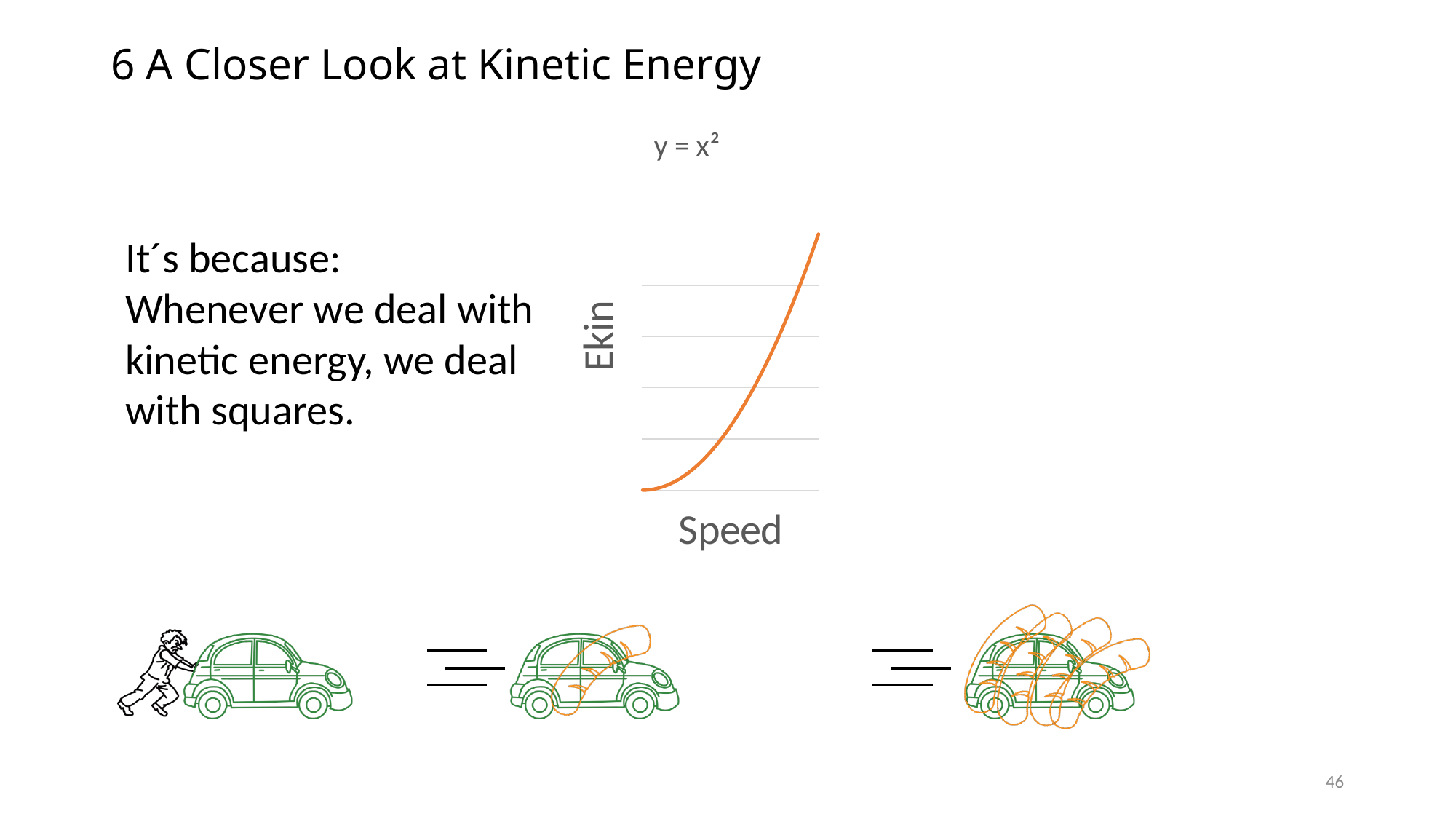
What is the label on the vertical axis of the chart? Ekin Do the values on the chart rise or fall as you move from left to right along the Speed axis? rise What is the title of the chart? y = x² How many lines are plotted on the chart? 1 What kind of chart is shown on the slide? line chart